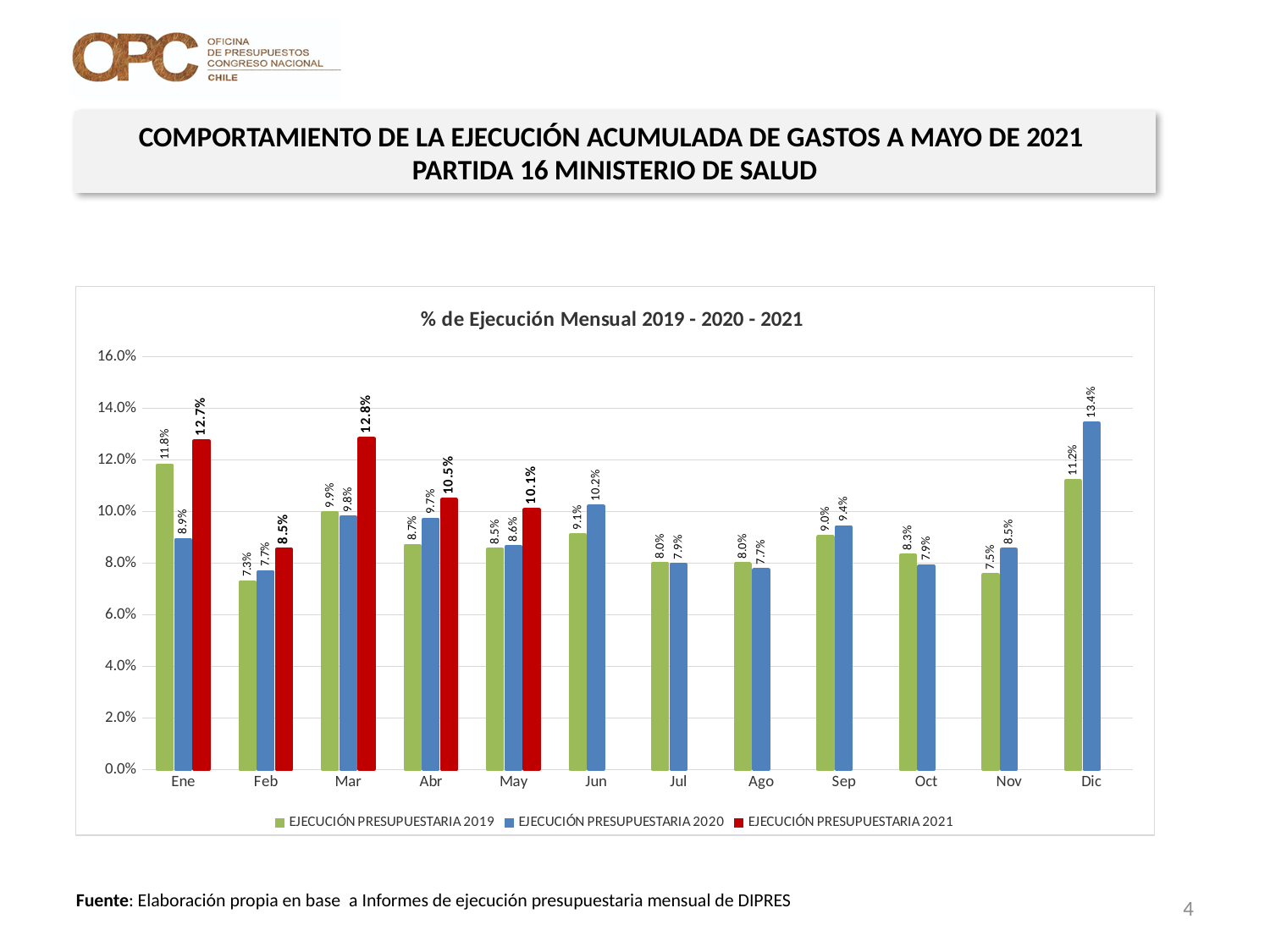
What is the title of the chart? % de Ejecución Mensual 2019 - 2020 - 2021 What is the value for EJECUCIÓN PRESUPUESTARIA 2021 in Mar? 12.8% What is the difference between the EJECUCIÓN PRESUPUESTARIA 2021 and EJECUCIÓN PRESUPUESTARIA 2019 values in Ene? 0.9% Which is larger in Abr: EJECUCIÓN PRESUPUESTARIA 2020 or EJECUCIÓN PRESUPUESTARIA 2019? EJECUCIÓN PRESUPUESTARIA 2020 In which month is the EJECUCIÓN PRESUPUESTARIA 2020 value the lowest? Feb and Ago Which colour represents EJECUCIÓN PRESUPUESTARIA 2021 in the chart? Red How many months are shown on the x axis? 12 What kind of chart is shown on the slide? Bar chart How many series does the legend list? 3 What is the value for EJECUCIÓN PRESUPUESTARIA 2019 in Feb? 7.3% In which month is the EJECUCIÓN PRESUPUESTARIA 2019 value the highest? Ene What is the value for EJECUCIÓN PRESUPUESTARIA 2020 in Dic? 13.4%